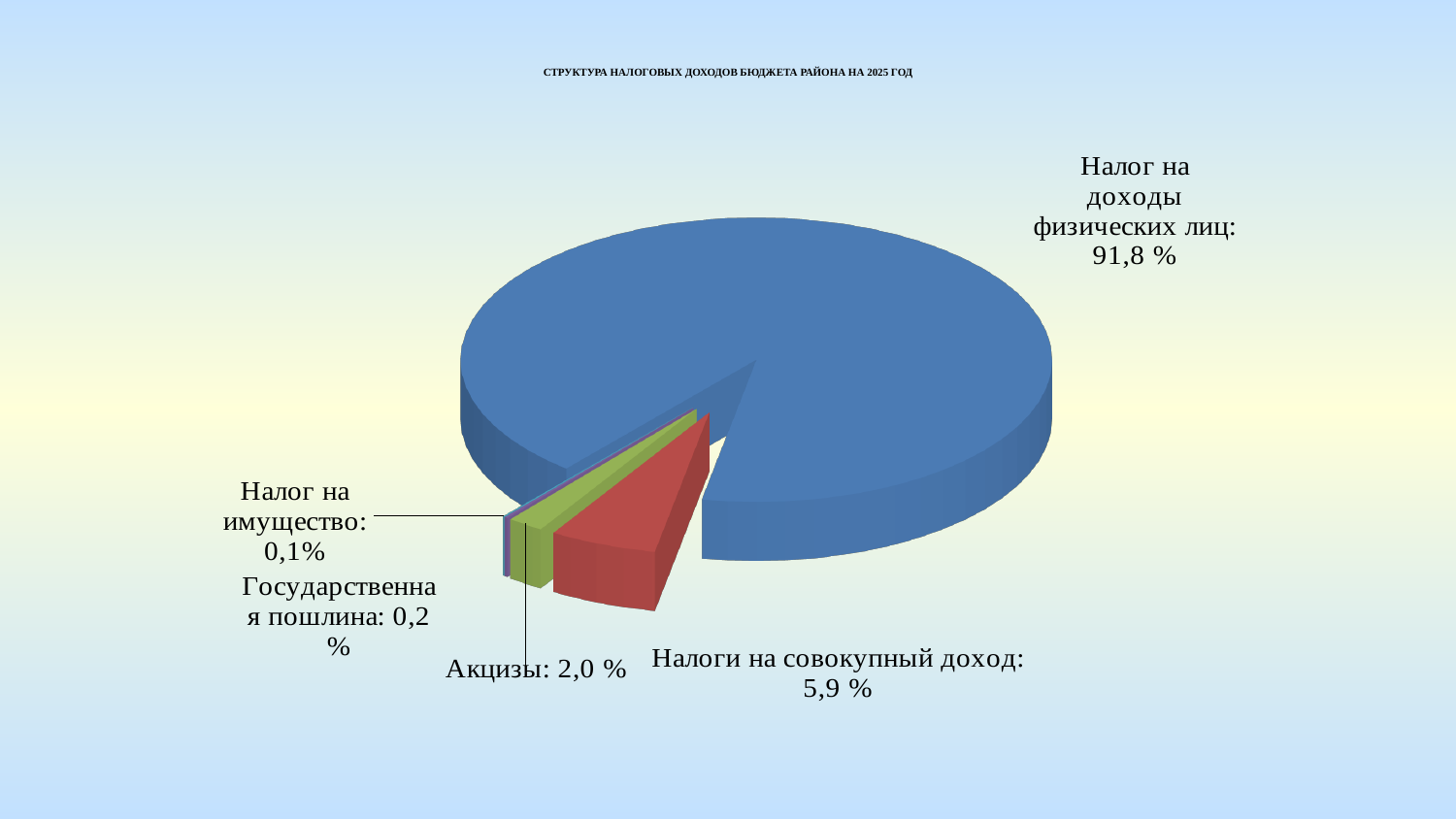
Which category has the largest share of the pie? Налог на доходы физических лиц What kind of chart is shown on the slide? pie chart What is the value shown for Налоги на совокупный доход? 5,9 % What is the difference between the shares of Налоги на совокупный доход and Акцизы? 3,9 % What is the value shown for Государственная пошлина? 0,2 % Which is larger, the share of Акцизы or the share of Государственная пошлина? Акцизы How many slices does the pie chart have? 5 What is the title of the chart? СТРУКТУРА НАЛОГОВЫХ ДОХОДОВ БЮДЖЕТА РАЙОНА НА 2025 ГОД What is the value shown for Налог на имущество? 0,1% Which category has the smallest share of the pie? Налог на имущество What share of the pie is Налог на доходы физических лиц? 91,8 % What is the value shown for Акцизы? 2,0 %